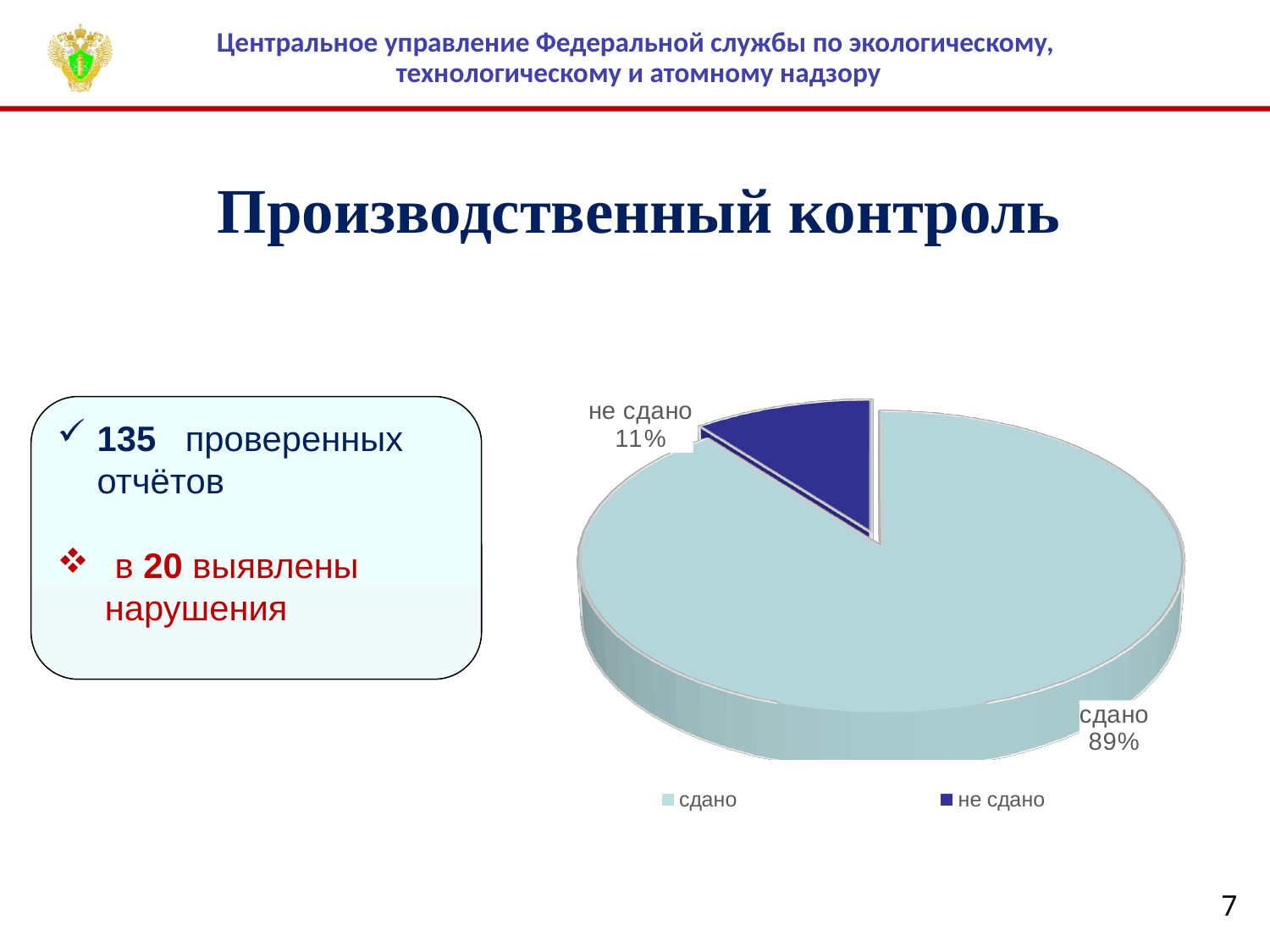
Which slice of the pie chart is the smallest? не сдано What colour is the "не сдано" slice in the pie chart? dark blue What share of the pie does the "сдано" slice represent? 89% What is the difference in percentage points between the "сдано" and "не сдано" slices? 78 What kind of chart is shown on the slide? pie chart Which is larger, the "сдано" slice or the "не сдано" slice? сдано How many entries does the legend list? 2 How many slices does the pie chart have? 2 Which slice of the pie chart is the largest? сдано What is the title of the slide containing the pie chart? Производственный контроль What share of the pie does the "не сдано" slice represent? 11%